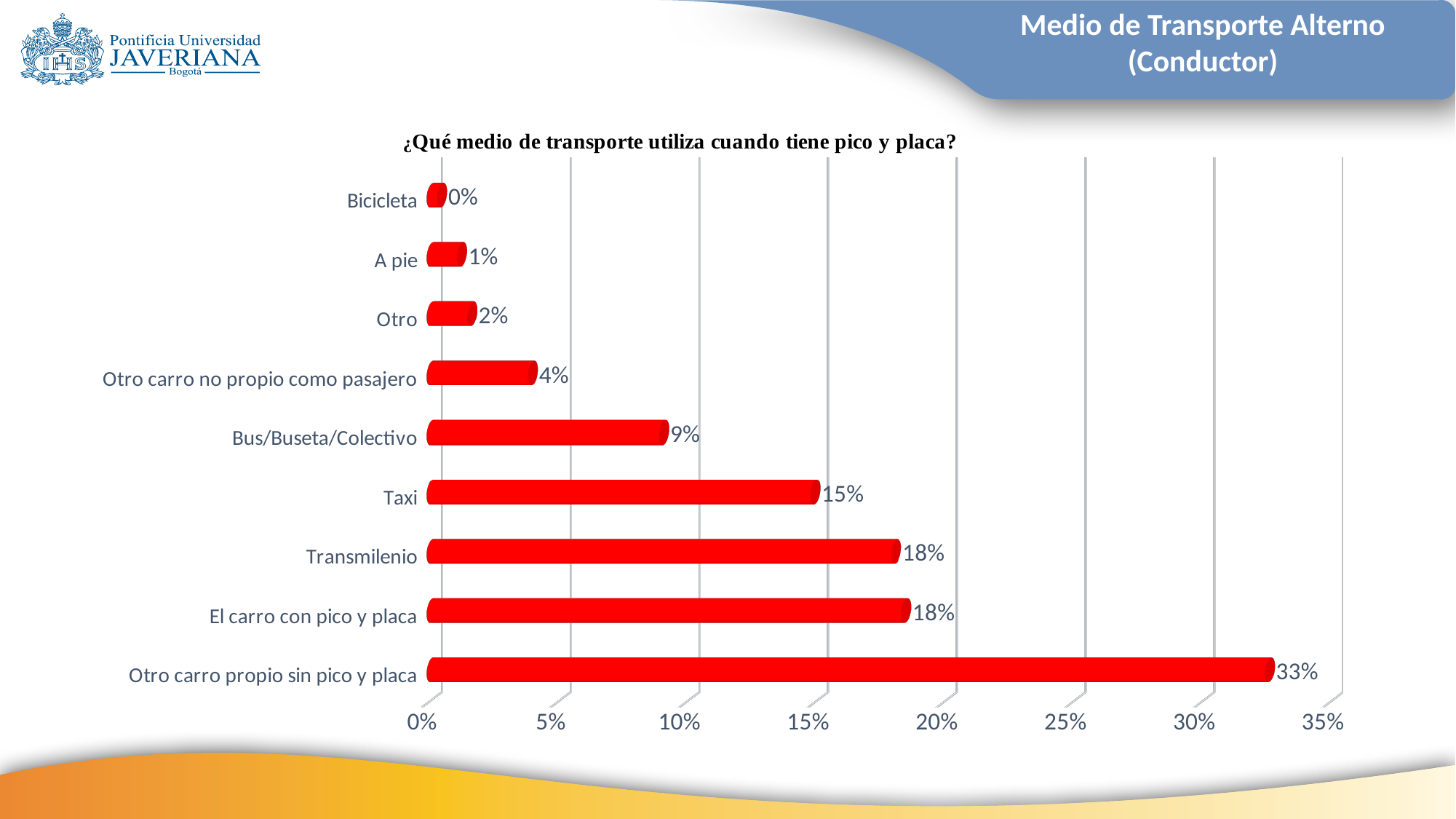
Which category has the lowest value? Bicicleta What is the title of the chart? ¿Qué medio de transporte utiliza cuando tiene pico y placa? What is the difference between the values for Otro carro propio sin pico y placa and Taxi? 18% How many categories are shown in the chart? 9 What is the difference between the values for Transmilenio and Bus/Buseta/Colectivo? 9% What kind of chart is shown on the slide? bar chart Which is larger, the value for Taxi or the value for Bus/Buseta/Colectivo? Taxi What value is shown for Otro carro no propio como pasajero? 4% Is the value for Otro carro propio sin pico y placa greater or less than 30%? greater What value is shown for Bus/Buseta/Colectivo? 9% What value is shown for Taxi? 15% Which category has the highest value? Otro carro propio sin pico y placa